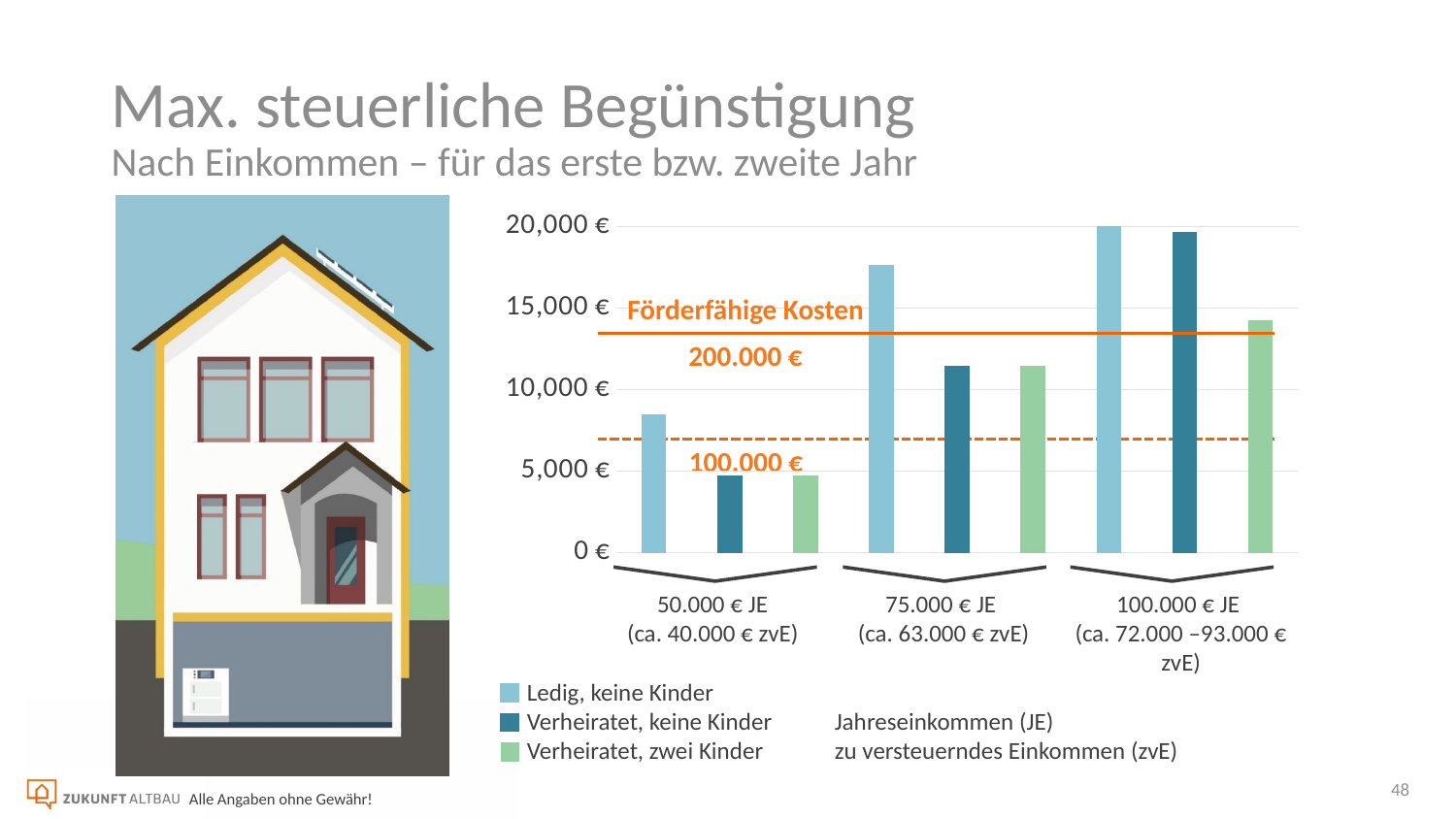
Is the value for Ledig, keine Kinder at 50.000 € JE greater or less than 5,000 €? greater At 50.000 € JE, which is larger: the bar for Ledig, keine Kinder or the bar for Verheiratet, keine Kinder? Ledig, keine Kinder What kind of chart is shown on the slide? bar chart How many series does the legend list? 3 What value is labelled on the solid orange line marked Förderfähige Kosten? 200.000 € In which income category is the bar for Ledig, keine Kinder the lowest? 50.000 € JE Is the value for Ledig, keine Kinder at 75.000 € JE greater or less than 15,000 €? greater How many income categories are shown on the x axis? 3 Is the value for Verheiratet, keine Kinder at 75.000 € JE greater or less than 10,000 €? greater Which series has the highest bar in the 100.000 € JE category? Ledig, keine Kinder Do the values for Ledig, keine Kinder rise or fall as income increases along the x axis? rise